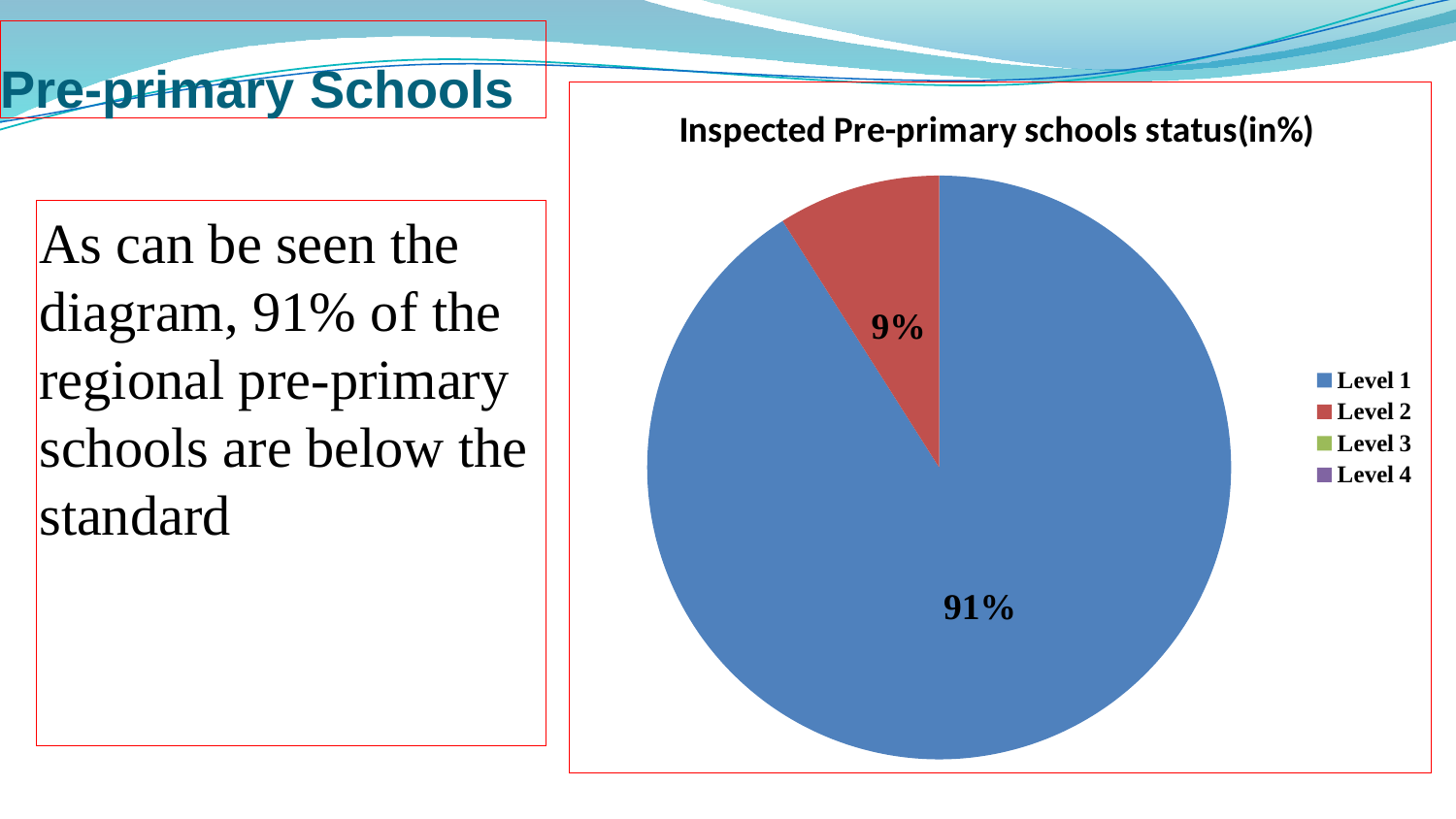
What is the difference in percentage points between the Level 1 and Level 2 slices? 82 Which level has the largest share of the pie? Level 1 What kind of chart is shown on the slide? pie chart What is the chart's title? Inspected Pre-primary schools status(in%) How many entries does the legend list? 4 What colour is the Level 2 slice? red Which of the two labelled slices is larger, Level 1 or Level 2? Level 1 What percentage of inspected pre-primary schools are at Level 1? 91% What percentage of inspected pre-primary schools are at Level 2? 9% How many slices are visible in the pie? 2 What is the combined share of the Level 1 and Level 2 slices? 100%